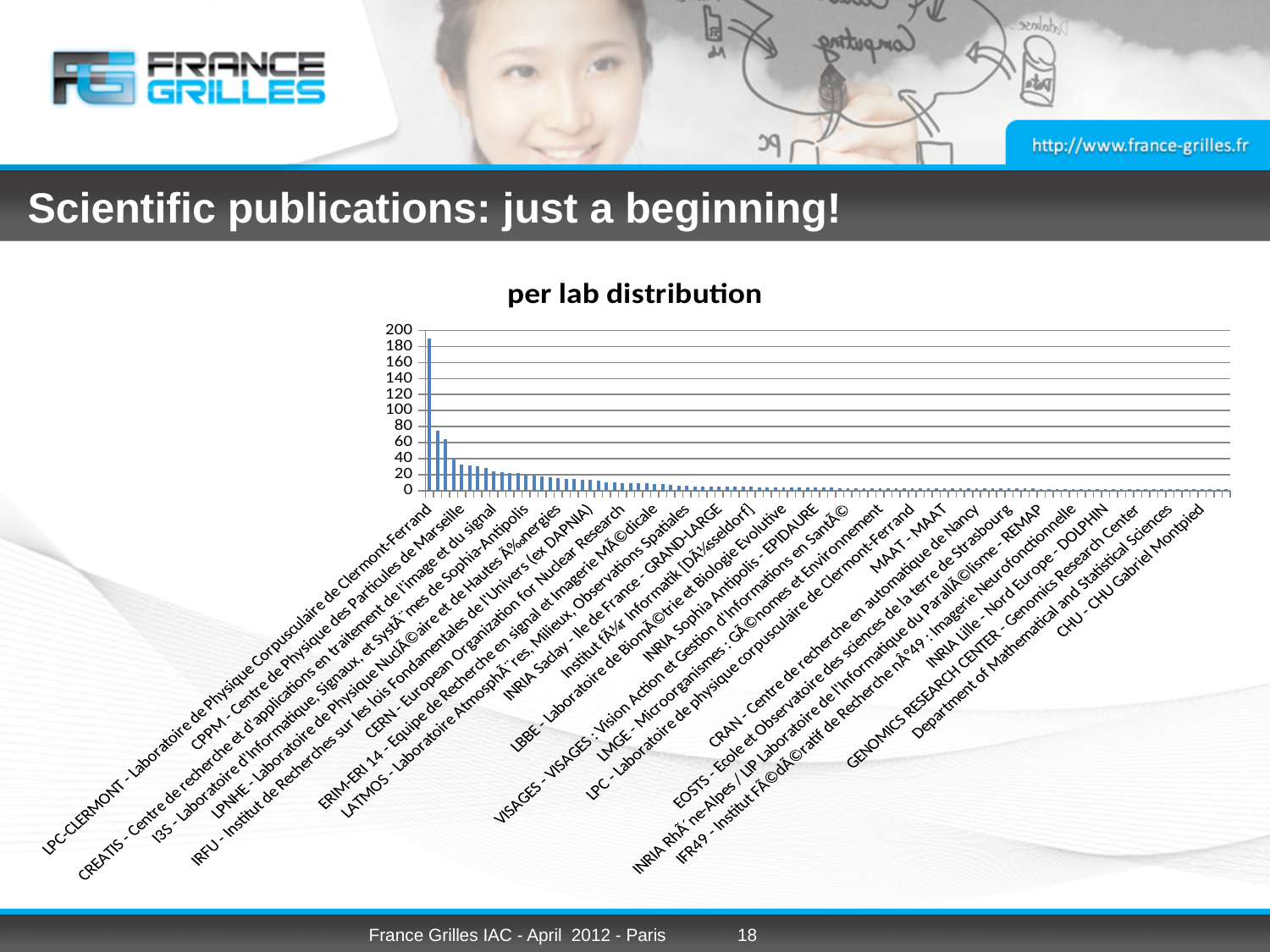
Which lab has the highest value in the chart? LPC-CLERMONT - Laboratoire de Physique Corpusculaire de Clermont-Ferrand Is the value for LPC-CLERMONT - Laboratoire de Physique Corpusculaire de Clermont-Ferrand greater or less than 180? greater What is the title of the chart? per lab distribution What kind of chart is shown on the slide? bar chart Is the value for CHU - CHU Gabriel Montpied greater or less than 20? less What is the highest tick value shown on the vertical axis? 200 Is the value for MAAT - MAAT greater or less than 20? less Which has the larger value: LPC-CLERMONT - Laboratoire de Physique Corpusculaire de Clermont-Ferrand or CPPM - Centre de Physique des Particules de Marseille? LPC-CLERMONT - Laboratoire de Physique Corpusculaire de Clermont-Ferrand Do the values rise or fall moving from left to right along the x axis? fall